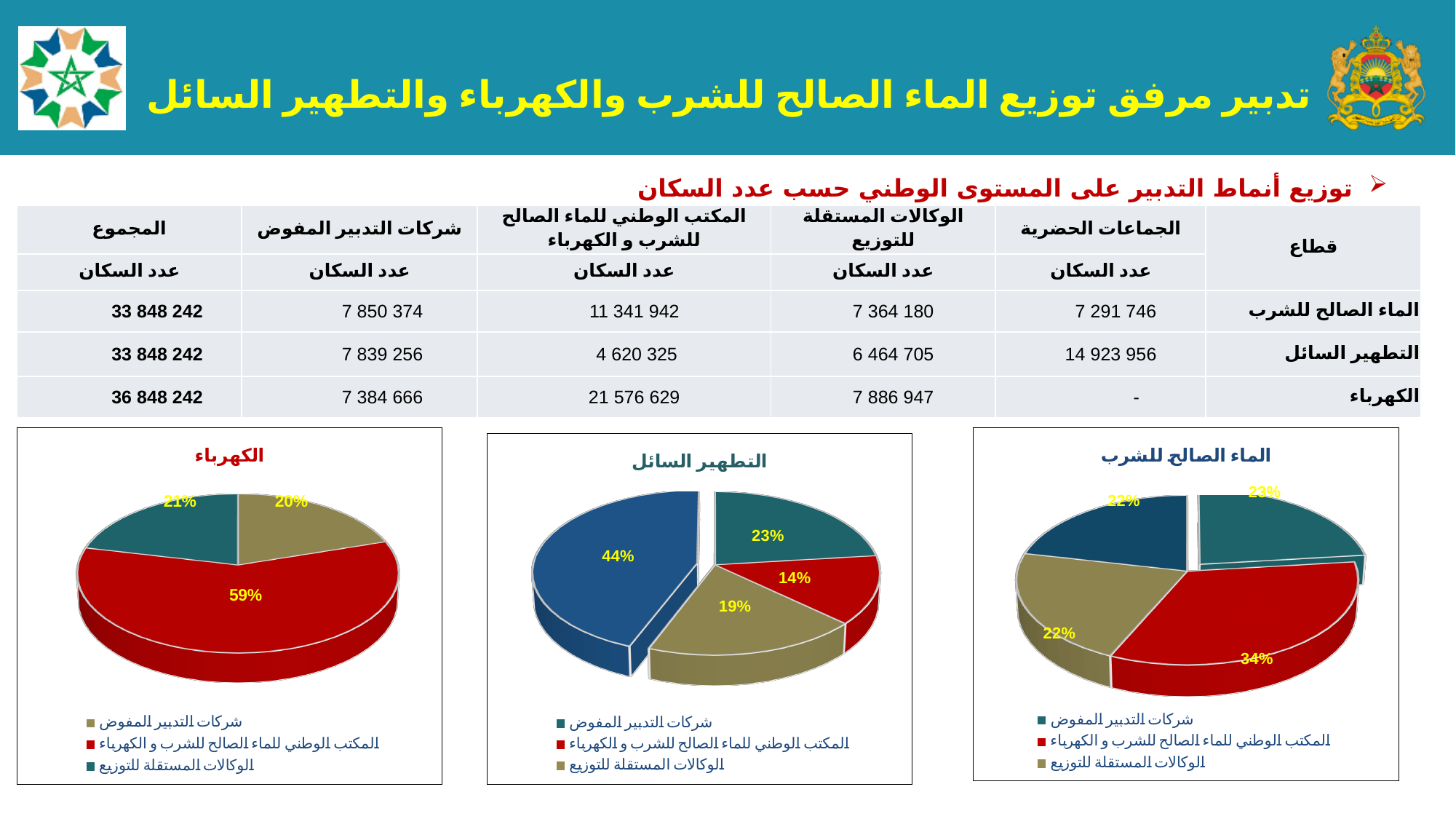
In the chart titled الكهرباء, what is the difference between the slice for المكتب الوطني للماء الصالح للشرب و الكهرباء and the slice for الوكالات المستقلة للتوزيع? 38% How many slices does the chart titled التطهير السائل have? 4 How many entries does the legend of the chart titled الماء الصالح للشرب list? 3 In the chart titled الكهرباء, what percentage is shown for شركات التدبير المفوض? 20% In the chart titled التطهير السائل, what is the percentage of the largest slice? 44% In the chart titled التطهير السائل, what percentage is shown for شركات التدبير المفوض? 23% In the chart titled الكهرباء, what percentage is shown for المكتب الوطني للماء الصالح للشرب و الكهرباء? 59% What kind of chart is the chart titled الكهرباء? Pie chart In the chart titled الماء الصالح للشرب, what percentage is shown for المكتب الوطني للماء الصالح للشرب و الكهرباء? 34% In the chart titled الكهرباء, which category has the largest slice? المكتب الوطني للماء الصالح للشرب و الكهرباء In the chart titled الماء الصالح للشرب, which is larger: the slice for شركات التدبير المفوض or the slice for الوكالات المستقلة للتوزيع? شركات التدبير المفوض In the chart titled التطهير السائل, what percentage is shown for المكتب الوطني للماء الصالح للشرب و الكهرباء? 14%